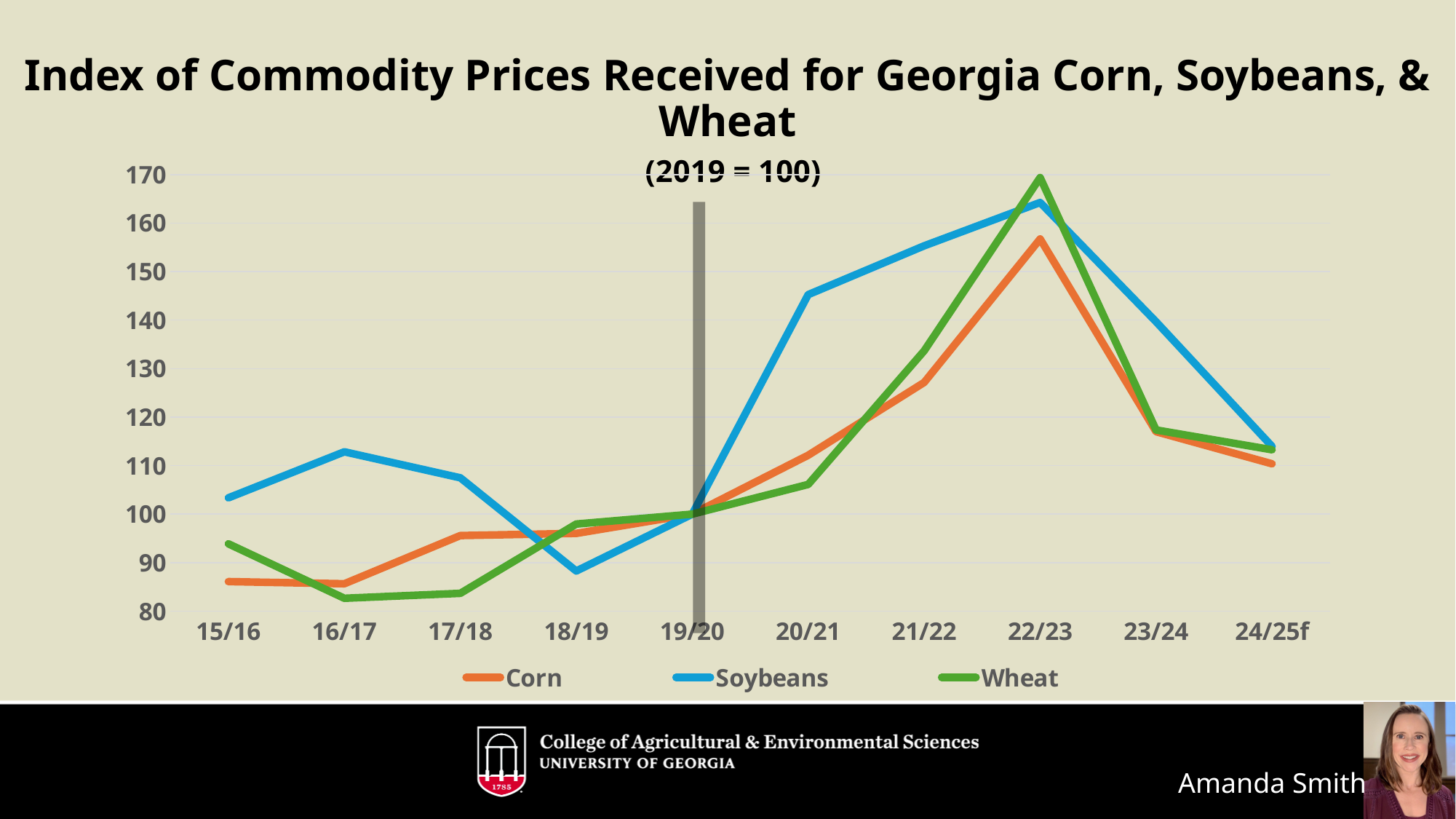
In 16/17, which is higher: Soybeans or Corn? Soybeans How many series does the legend list? 3 In which year does the Wheat index reach its peak? 22/23 Is the Corn value for 22/23 greater or less than 150? greater How many marketing years are shown on the x axis? 10 In which year is the Soybeans index at its lowest? 18/19 Is the Wheat value for 16/17 greater or less than 90? less What type of chart is shown on the slide? line chart Which series reaches the highest value in 22/23? Wheat Is the Soybeans value for 20/21 greater or less than 140? greater What colour is the Corn line? orange Does the Corn index rise or fall from 19/20 to 22/23? rise